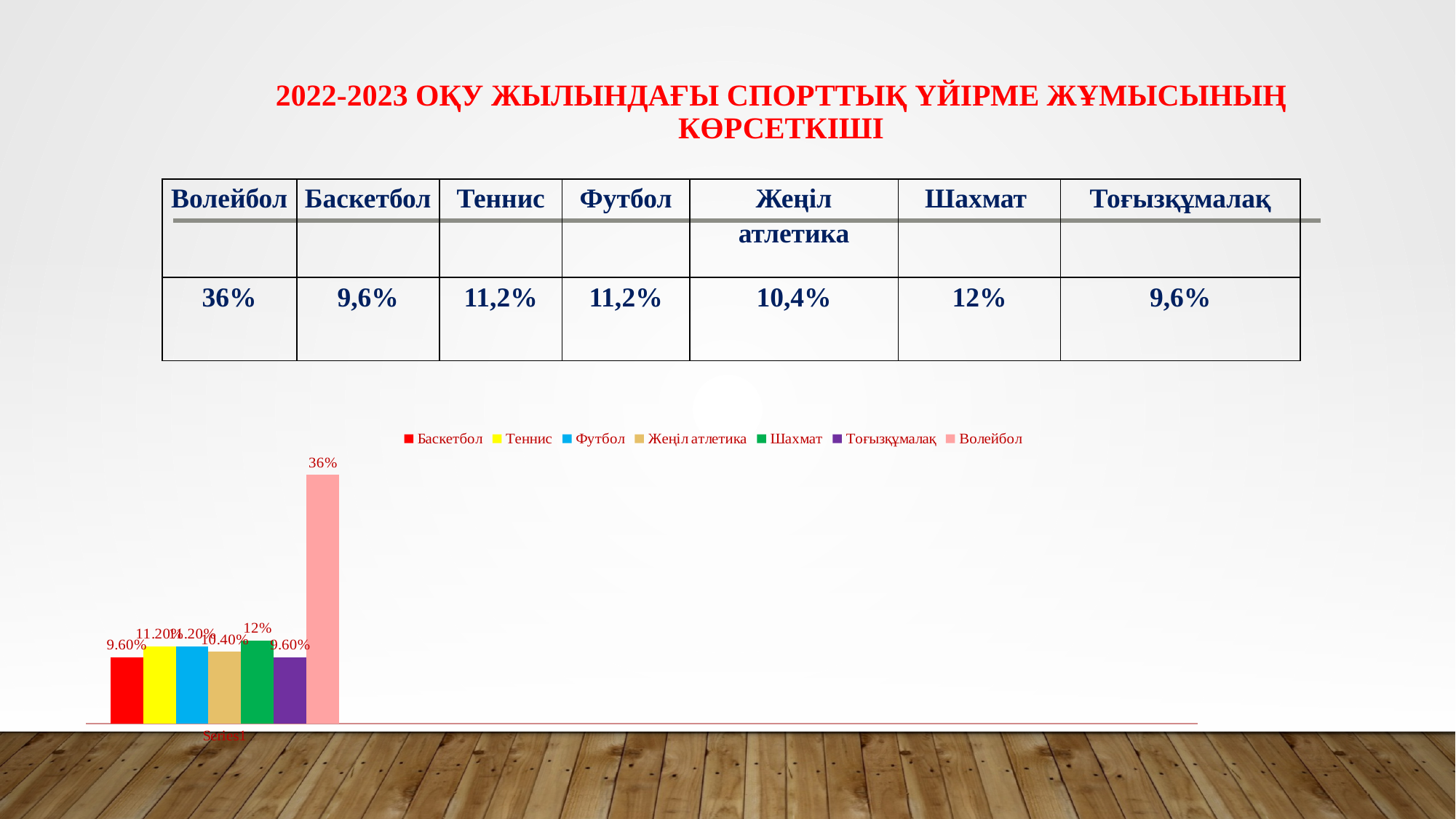
Which is larger in the chart, the value for Шахмат or the value for Жеңіл атлетика? Шахмат How many series does the chart legend list? 7 What is the value shown for Шахмат in the chart? 12% Which series has the highest value in the chart? Волейбол What is the value shown for Волейбол in the chart? 36% What kind of chart is shown on the slide? bar chart What is the value shown for Баскетбол in the chart? 9.60% What is the difference between the values for Волейбол and Шахмат in the chart? 24% Which series is shown in pink in the chart legend? Волейбол What label appears on the category axis of the chart? Series1 What is the value shown for Жеңіл атлетика in the chart? 10.40% What is the difference between the values for Теннис and Баскетбол in the chart? 1.60%